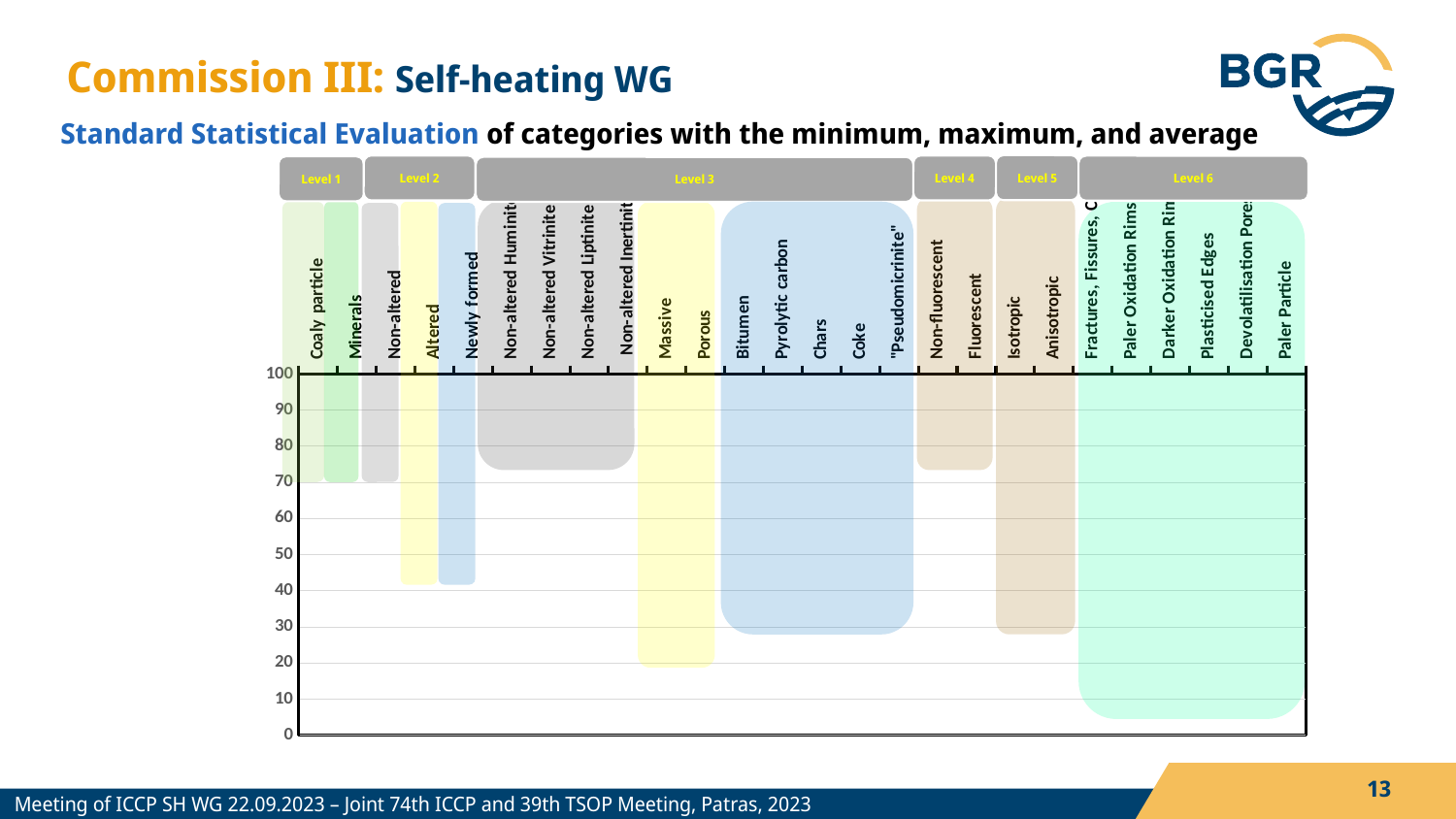
Which two categories are grouped under Level 1 in the chart? Coaly particle and Minerals How many categories are grouped under Level 2 in the chart? 3 How many categories are grouped under Level 3 in the chart? 11 How many categories are labelled along the x axis of the chart? 26 Which level group contains the most categories in the chart? Level 3 What is the highest value shown on the chart's y axis? 100